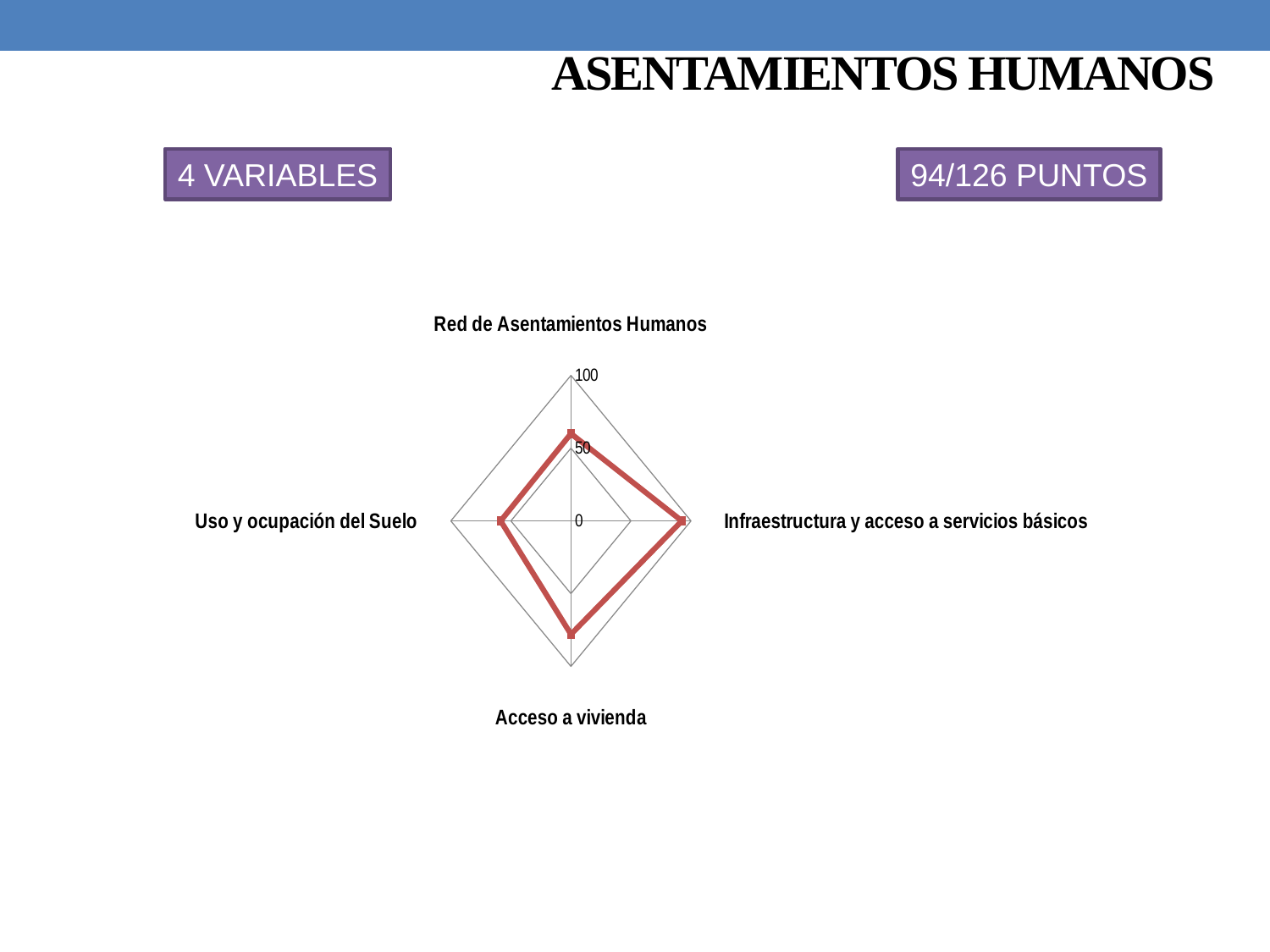
Which is larger, the value for Infraestructura y acceso a servicios básicos or the value for Acceso a vivienda? Infraestructura y acceso a servicios básicos How many categories (axes) does the radar chart have? 4 What is the maximum value shown on the radar chart's axis scale? 100 Is the value for Infraestructura y acceso a servicios básicos greater or less than 50? greater Is the value for Red de Asentamientos Humanos greater or less than 100? less What kind of chart is shown on the slide? radar chart Is the value for Uso y ocupación del Suelo greater or less than 100? less What colour is the data line plotted on the radar chart? red Which is larger, the value for Acceso a vivienda or the value for Red de Asentamientos Humanos? Acceso a vivienda Which category has the highest value in the radar chart? Infraestructura y acceso a servicios básicos